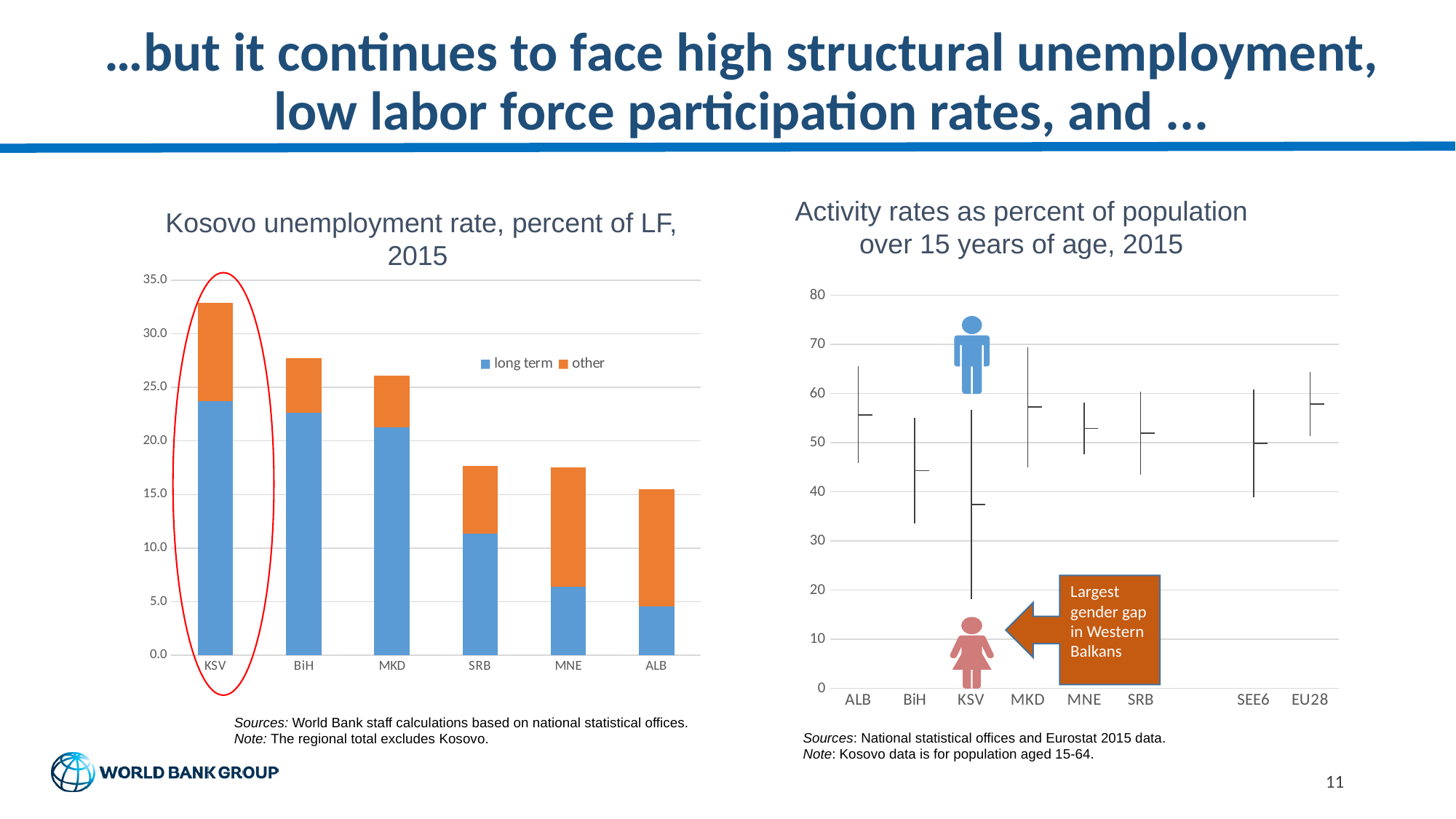
On the 'Kosovo unemployment rate, percent of LF, 2015' chart, is the total value for KSV greater or less than 30.0? greater On the 'Kosovo unemployment rate, percent of LF, 2015' chart, which country has the lowest total unemployment rate? ALB What kind of chart is the 'Kosovo unemployment rate, percent of LF, 2015' chart? Stacked bar chart On the 'Kosovo unemployment rate, percent of LF, 2015' chart, which country has the highest total unemployment rate? KSV On the 'Kosovo unemployment rate, percent of LF, 2015' chart, which has the larger long term value, MKD or SRB? MKD How many series does the legend of the 'Kosovo unemployment rate, percent of LF, 2015' chart list? 2 On the 'Kosovo unemployment rate, percent of LF, 2015' chart, do the total bar heights generally rise or fall from left to right? Fall On the 'Kosovo unemployment rate, percent of LF, 2015' chart, is the long term value for ALB greater or less than 5.0? less How many countries are shown on the 'Kosovo unemployment rate, percent of LF, 2015' chart? 6 What are the two legend entries on the 'Kosovo unemployment rate, percent of LF, 2015' chart? long term and other How many categories are shown on the x axis of the 'Activity rates as percent of population over 15 years of age, 2015' chart? 8 On the 'Activity rates as percent of population over 15 years of age, 2015' chart, which country is annotated as having the largest gender gap in Western Balkans? KSV